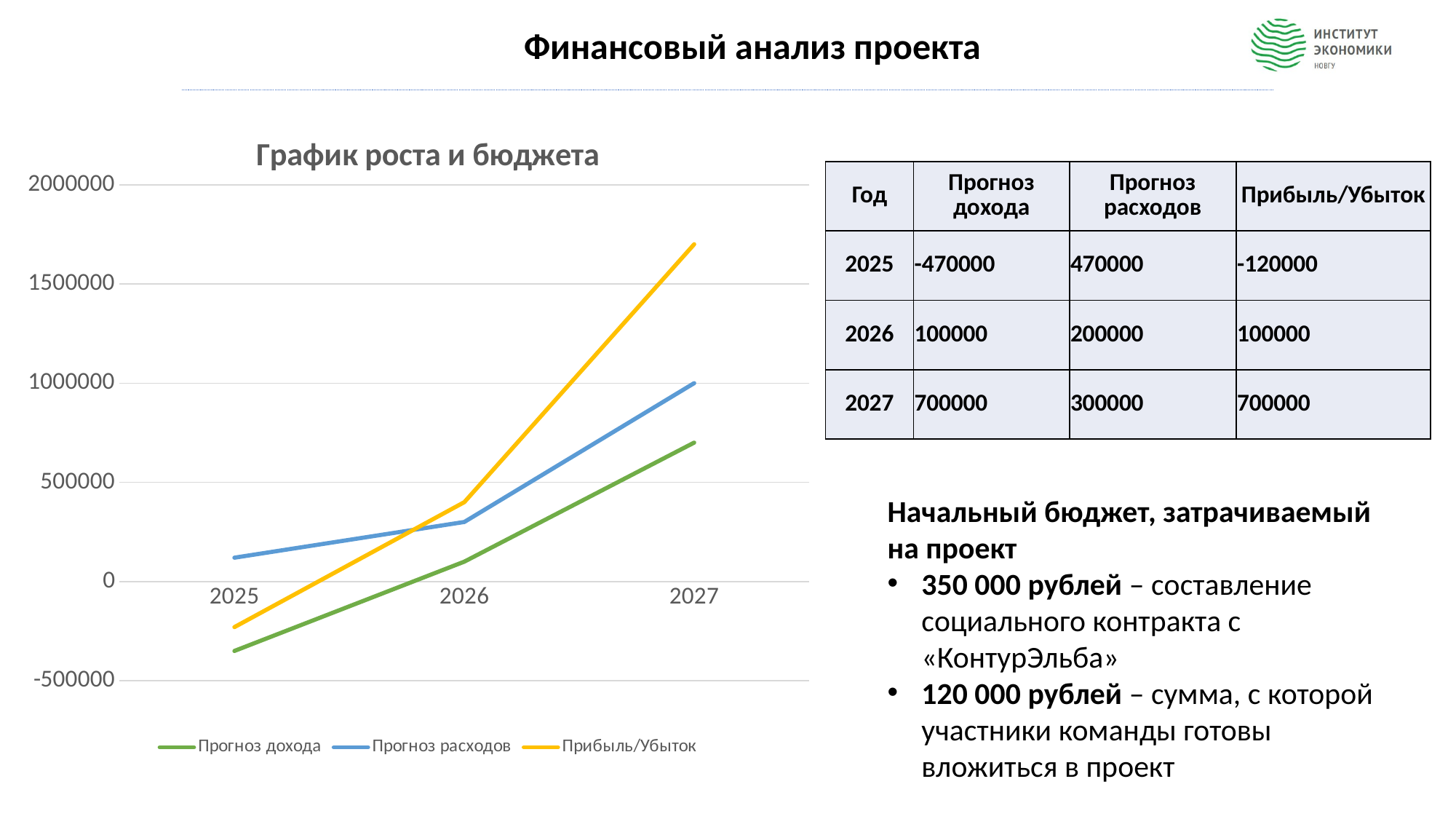
Is the value for "Прибыль/Убыток" in 2027 greater or less than 1500000? greater Does the "Прибыль/Убыток" line rise or fall from 2025 to 2027? rise In 2027, which is larger: "Прибыль/Убыток" or "Прогноз расходов"? Прибыль/Убыток Is the value for "Прогноз расходов" in 2025 greater or less than 500000? less In 2025, which is larger: "Прогноз расходов" or "Прогноз дохода"? Прогноз расходов What is the title of the chart? График роста и бюджета What kind of chart is "График роста и бюджета"? line chart Which series has the lowest value in 2025? Прогноз дохода Which series has the highest value in 2027? Прибыль/Убыток How many years are shown on the x axis of the chart? 3 Is the value for "Прогноз дохода" in 2025 greater or less than 0? less How many series does the legend of the chart list? 3